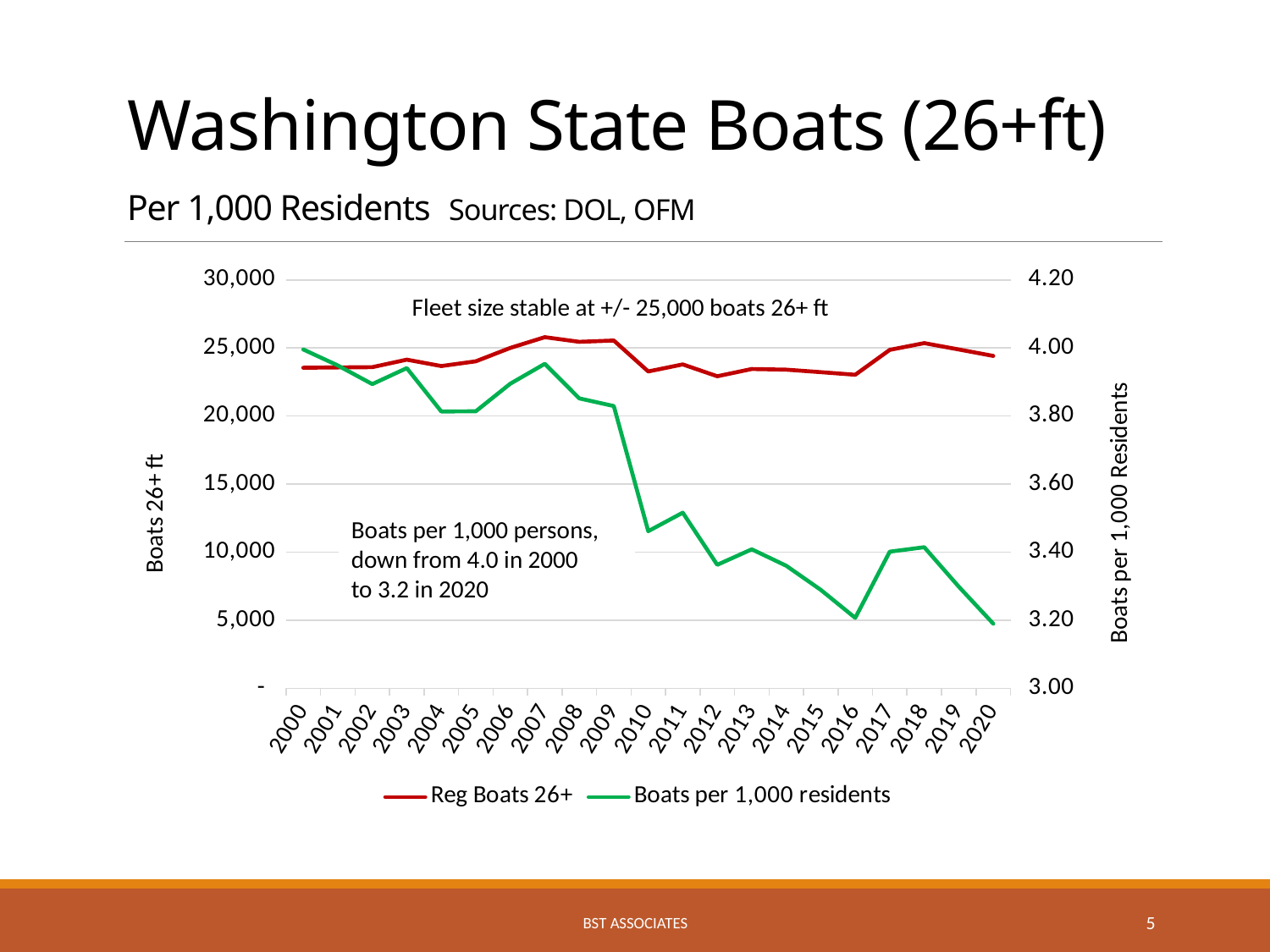
In which year is the Boats per 1,000 residents value highest? 2000 According to the annotation on the chart, what was the boats per 1,000 persons value in 2020? 3.2 Does the Boats per 1,000 residents line generally rise or fall from 2000 to 2020? fall How many years are plotted along the x axis? 21 What is the title of the right-hand vertical axis? Boats per 1,000 Residents Is the Boats per 1,000 residents value for 2016 greater or less than 3.40? less Which year has the higher Boats per 1,000 residents value, 2009 or 2010? 2009 How many series does the legend list? 2 Is the Boats per 1,000 residents value for 2000 greater or less than 3.80? greater What colour is the Reg Boats 26+ line? red What kind of chart is shown on the slide? line chart Is the Reg Boats 26+ value for 2010 greater or less than 25,000? less